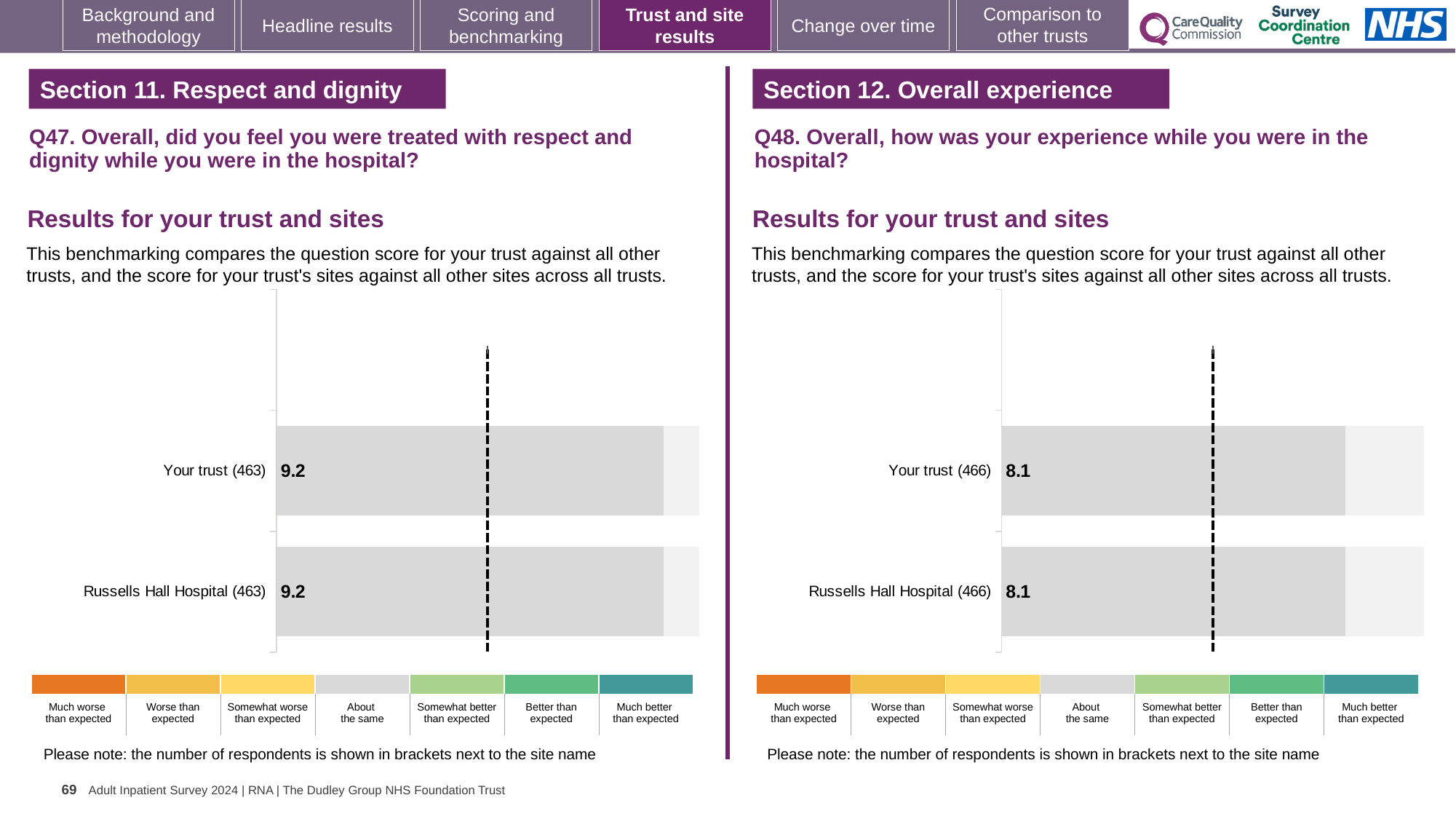
On the Q48 chart (right), what is the score for Russells Hall Hospital? 8.1 On the Q48 chart (right), what is the difference between the score for Your trust and the score for Russells Hall Hospital? 0.0 How many categories does the colour key below each chart list, from 'Much worse than expected' to 'Much better than expected'? 7 How many bars are plotted on the Q48 chart (right)? 2 What kind of chart is used for the Q47 results on the left? Bar chart On the Q47 chart (left), what is the difference between the score for Your trust and the score for Russells Hall Hospital? 0.0 On the Q48 chart (right), how many respondents are shown in brackets next to Russells Hall Hospital? 466 On the Q47 chart (left), what is the score for Your trust? 9.2 On the Q48 chart (right), what is the score for Your trust? 8.1 On the Q47 chart (left), how many respondents are shown in brackets next to Your trust? 463 How many bars are plotted on the Q47 chart (left)? 2 On the Q47 chart (left), what is the score for Russells Hall Hospital? 9.2